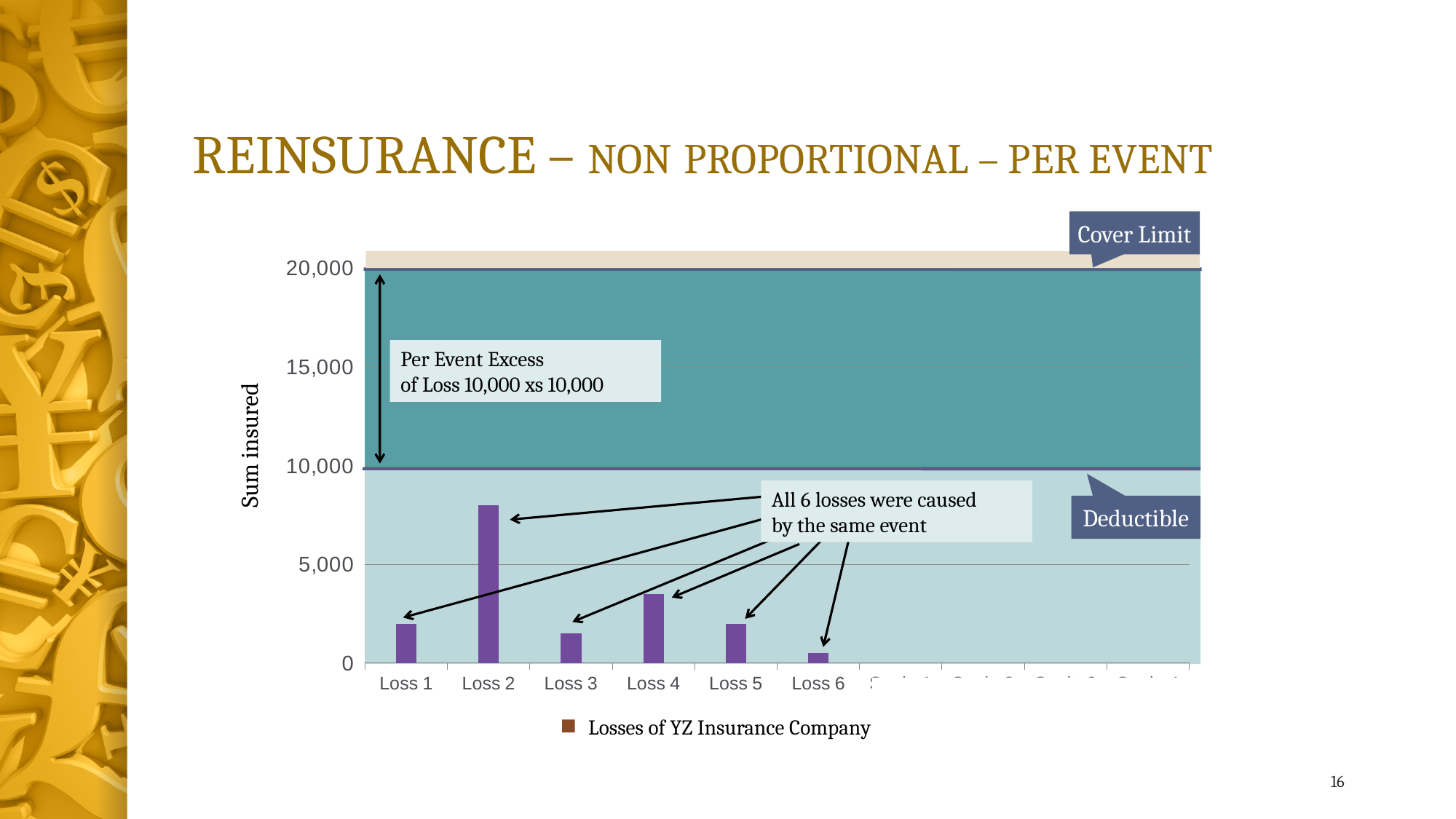
How many series does the chart legend list? 1 What is the legend entry for the bars in the chart? Losses of YZ Insurance Company Is the value for Loss 2 greater or less than 10,000? less Is the value for Loss 2 greater or less than 5,000? greater How many loss categories are labelled on the x axis of the chart? 6 Is the value for Loss 4 greater or less than 5,000? less What kind of chart is shown on the slide? Bar chart Which loss has the lowest value in the chart? Loss 6 What is the title of the vertical axis of the chart? Sum insured Which is larger, the value for Loss 2 or the value for Loss 4? Loss 2 Which is larger, the value for Loss 4 or the value for Loss 3? Loss 4 Which loss has the highest value in the chart? Loss 2